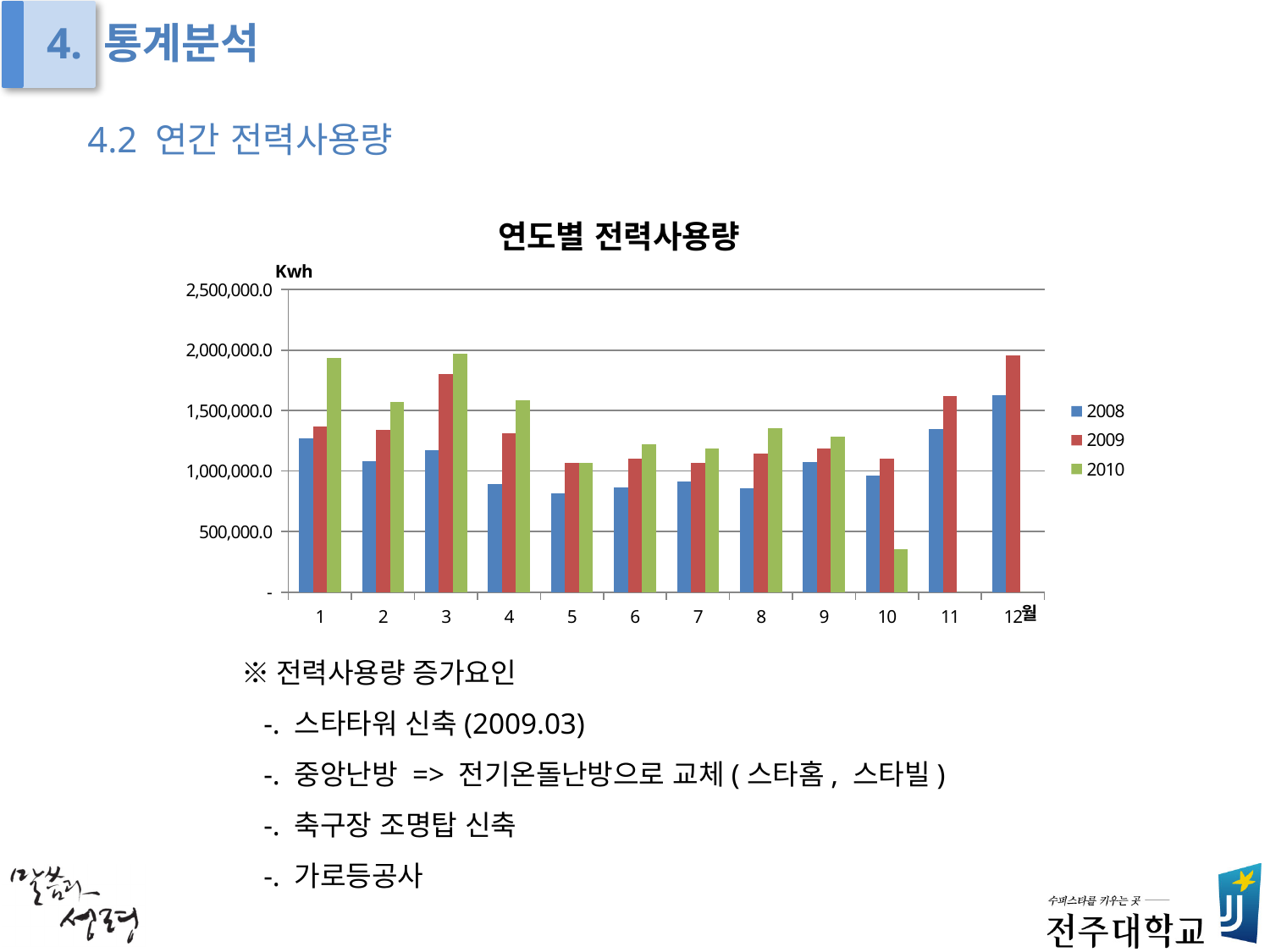
Is the 2008 value for month 5 greater or less than 1,000,000.0? less Which month has the highest value for the 2008 series? 12 What kind of chart is shown on the slide? Bar chart How many series does the legend of the 연도별 전력사용량 chart list? 3 Is the 2010 value for month 10 greater or less than 500,000.0? less In month 1, which series has the larger value, 2008 or 2010? 2010 Which month has the highest value for the 2009 series? 12 In month 11, which series has the larger value, 2008 or 2009? 2009 What unit is shown at the top of the y axis of the chart? Kwh How many month categories are shown on the x axis of the chart? 12 Is the 2009 value for month 12 greater or less than 1,500,000.0? greater